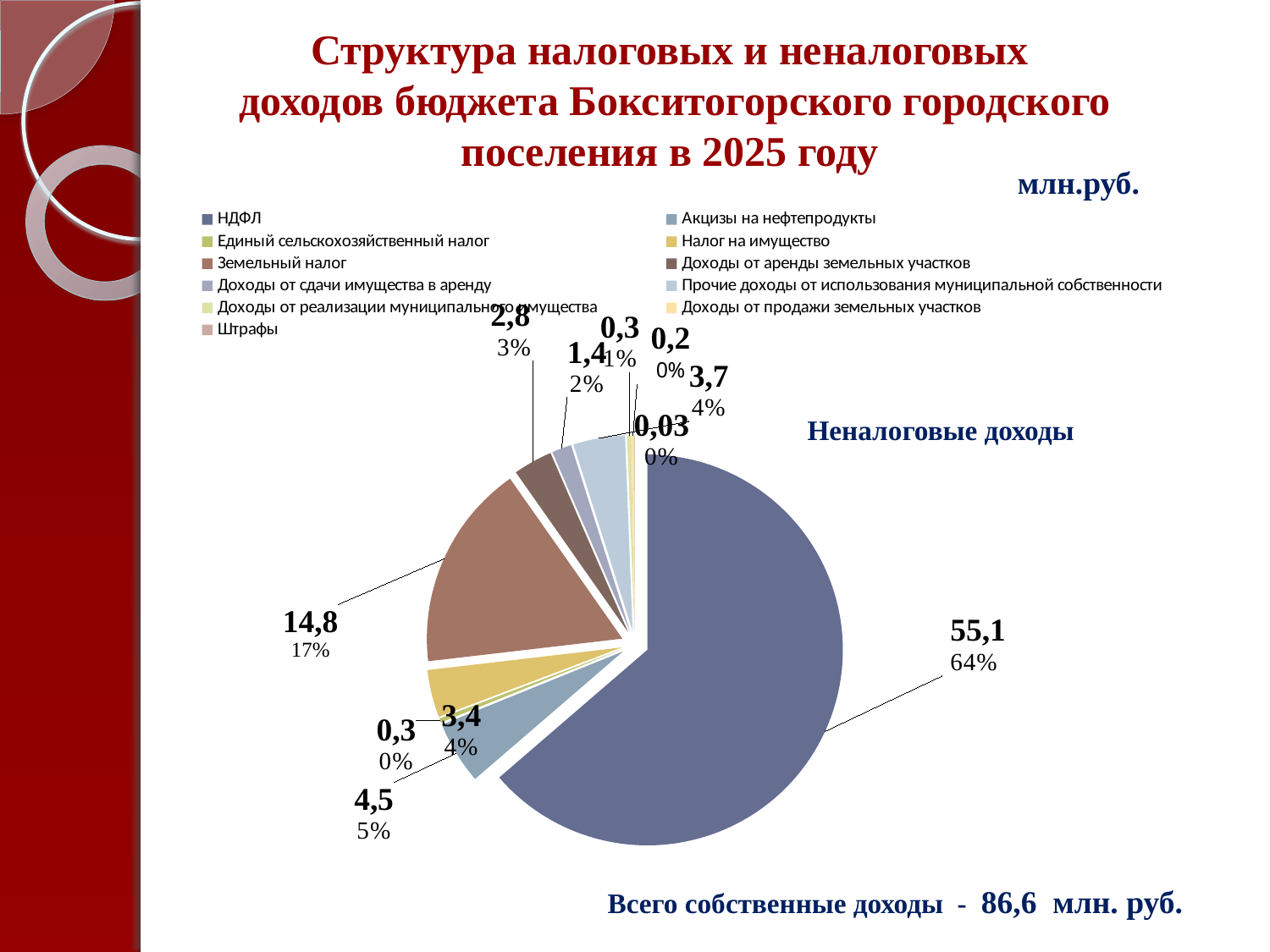
What total of own revenues is stated below the chart? 86,6 млн. руб. What is the smallest data label value shown on the pie chart? 0,03 How many entries does the chart legend list? 11 What share of the pie does Земельный налог account for? 17% What kind of chart is shown on the slide? pie chart What unit of measurement is indicated for the chart values? млн.руб. What is the value shown for Земельный налог? 14,8 What share of the pie does НДФЛ account for? 64% Which is larger: the slice labelled 14,8 or the slice labelled 4,5? 14,8 What is the difference between the values for НДФЛ (55,1) and Земельный налог (14,8)? 40,3 What is the value shown for НДФЛ? 55,1 Which category has the largest slice of the pie? НДФЛ